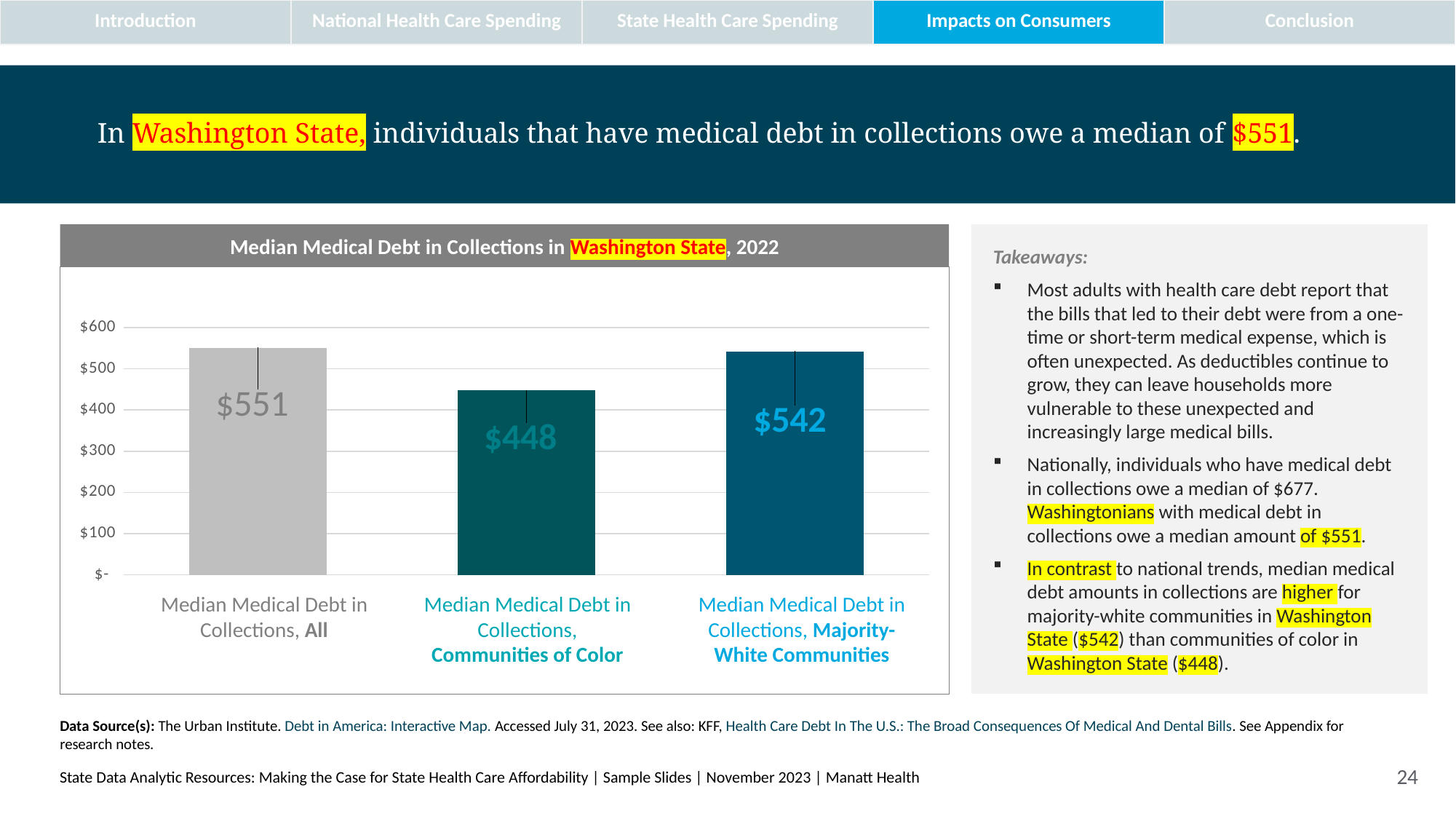
How many categories are shown in the chart? 3 What is the title of the chart? Median Medical Debt in Collections in Washington State, 2022 Which category has the highest median medical debt in collections? All What is the difference between the median medical debt for Majority-White Communities and Communities of Color? $94 What is the median medical debt in collections for Communities of Color? $448 Which is larger, the median medical debt for Majority-White Communities or for Communities of Color? Majority-White Communities What kind of chart is shown on the slide? bar chart What is the median medical debt in collections for Majority-White Communities? $542 Is the value for Communities of Color greater or less than $500? less What is the median medical debt in collections for All in the chart? $551 What is the difference between the median medical debt for All and Communities of Color? $103 Which category has the lowest median medical debt in collections? Communities of Color